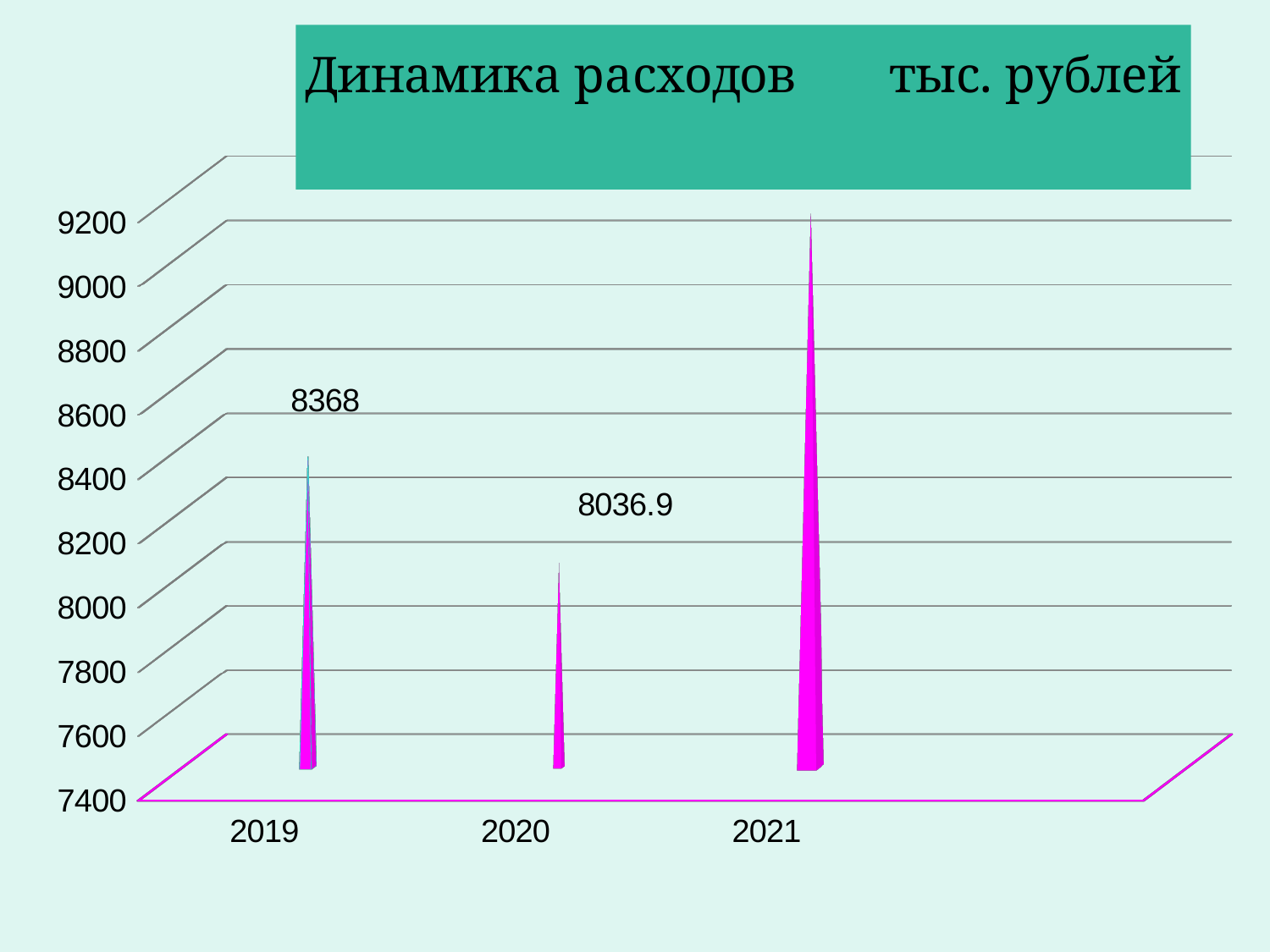
Which is larger, the value for 2019 or the value for 2020? 2019 What is the difference between the values for 2019 and 2020? 331.1 What is the value for 2019? 8368 Does the value rise or fall from 2020 to 2021? rise What is the value for 2020? 8036.9 What kind of chart is shown on the slide? bar chart Is the value for 2021 greater or less than 9000? greater How many years are shown on the x axis? 3 Is the value for 2020 greater or less than 8200? less Which year has the highest value? 2021 Which year has the lowest value? 2020 What is the title of the chart? Динамика расходов тыс. рублей